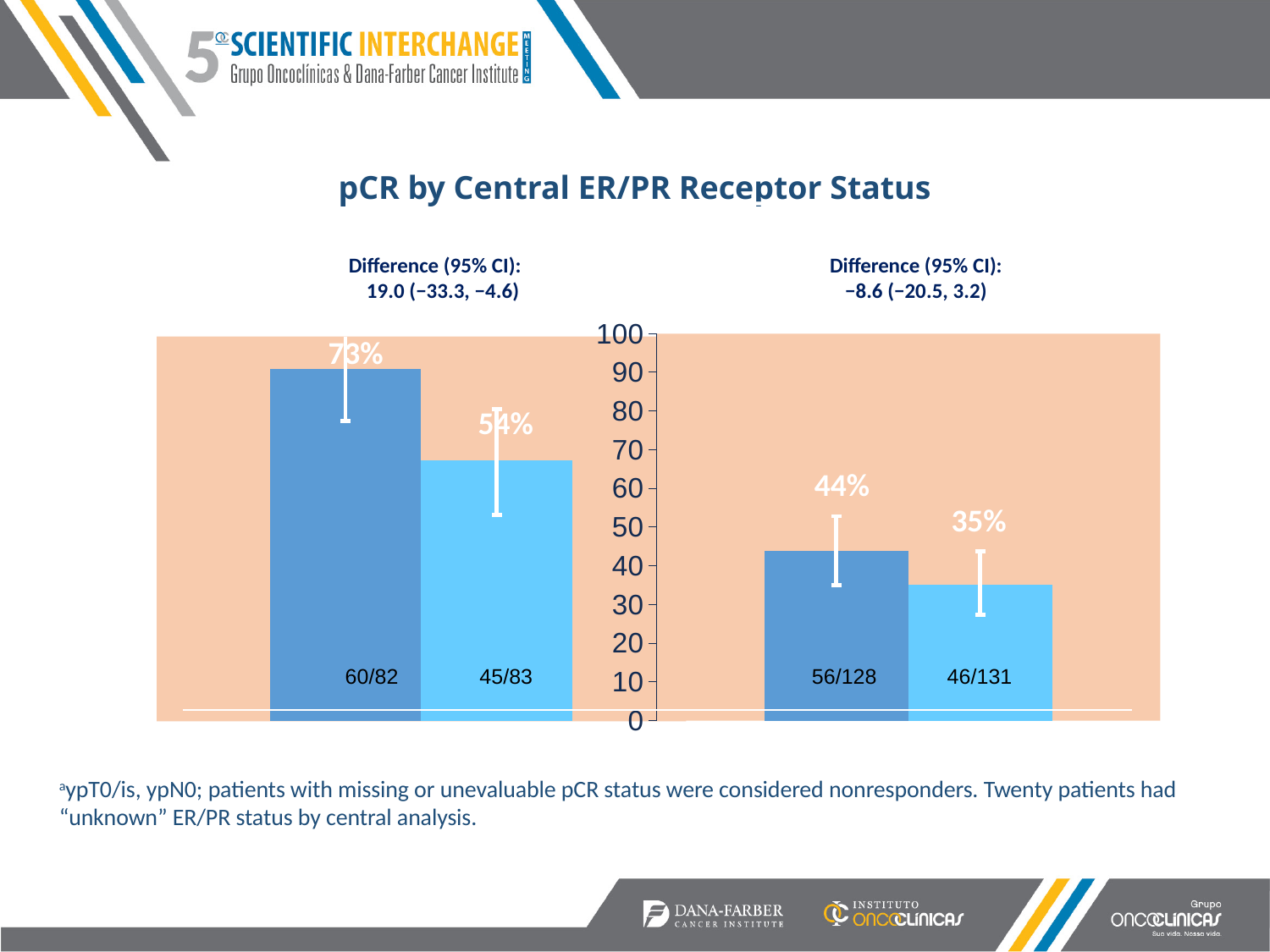
What is the value labelled on the dark blue bar in the right group? 44% What is the value labelled on the light blue bar in the left group? 54% Which bar has the highest value? The dark blue bar in the left group (73%) Which is larger, the dark blue bar in the left group or the dark blue bar in the right group? The dark blue bar in the left group What is the value labelled on the dark blue bar in the left group? 73% What type of chart is shown on the slide? Bar chart Which bar has the lowest value? The light blue bar in the right group (35%) How many bars are plotted in the chart? 4 What is the value labelled on the light blue bar in the right group? 35% What is the difference between the dark blue and light blue bars in the left group? 19 percentage points What fraction is printed at the base of the dark blue bar in the left group? 60/82 What is the title of the chart? pCR by Central ER/PR Receptor Status